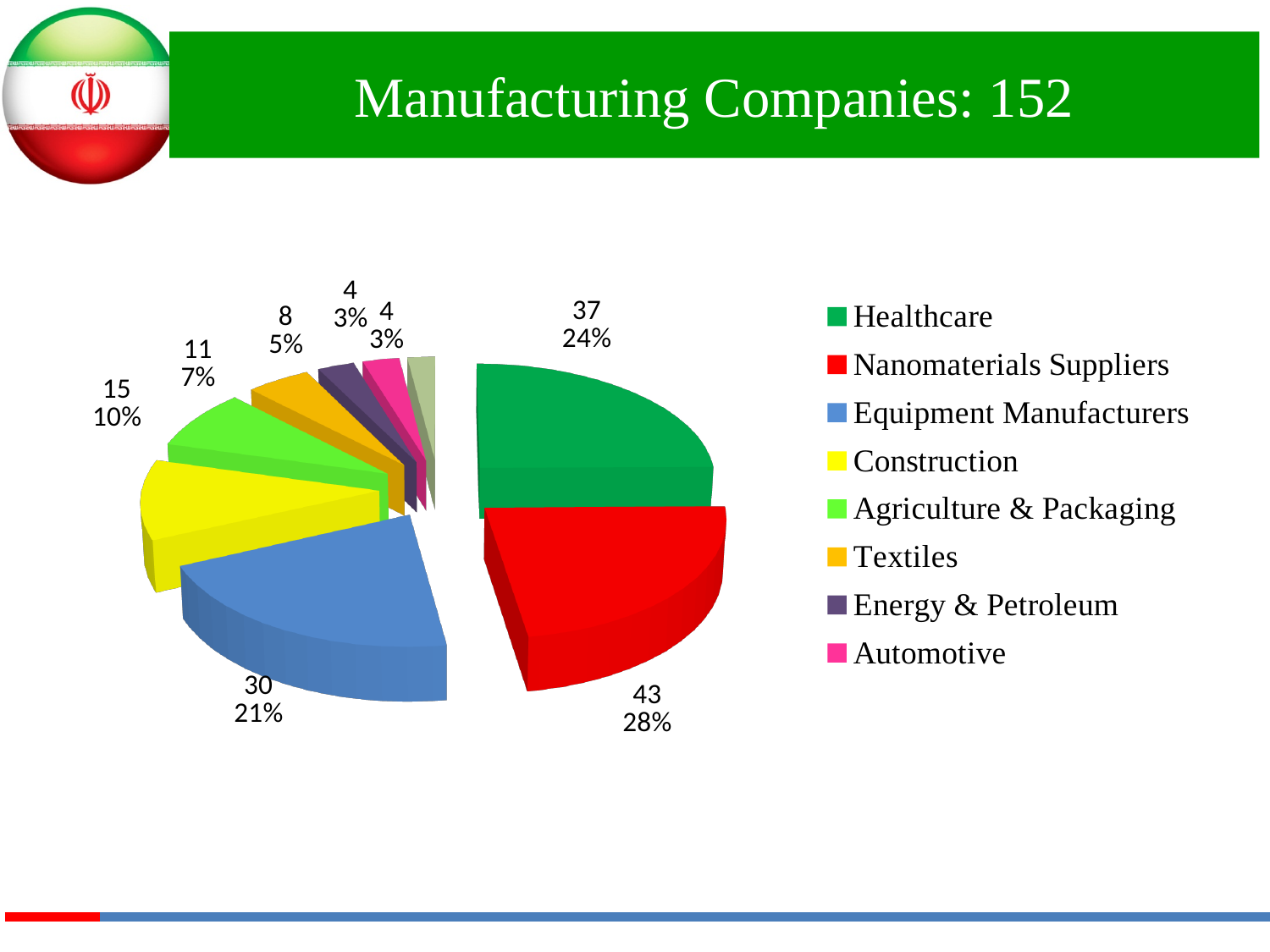
What type of chart is shown on the slide? Pie chart How many companies are in the Healthcare slice? 37 What value is shown for Equipment Manufacturers? 30 What is the title of the chart on the slide? Manufacturing Companies: 152 Which is larger, the Construction slice or the Agriculture & Packaging slice? Construction What percentage share does the Construction slice have? 10% What value is shown for Textiles? 8 How many entries does the chart's legend list? 8 What percentage share does the Nanomaterials Suppliers slice have? 28% What is the difference between the Nanomaterials Suppliers value and the Healthcare value? 6 What percentage share does the Energy & Petroleum slice have? 3% Which category has the largest slice of the pie? Nanomaterials Suppliers